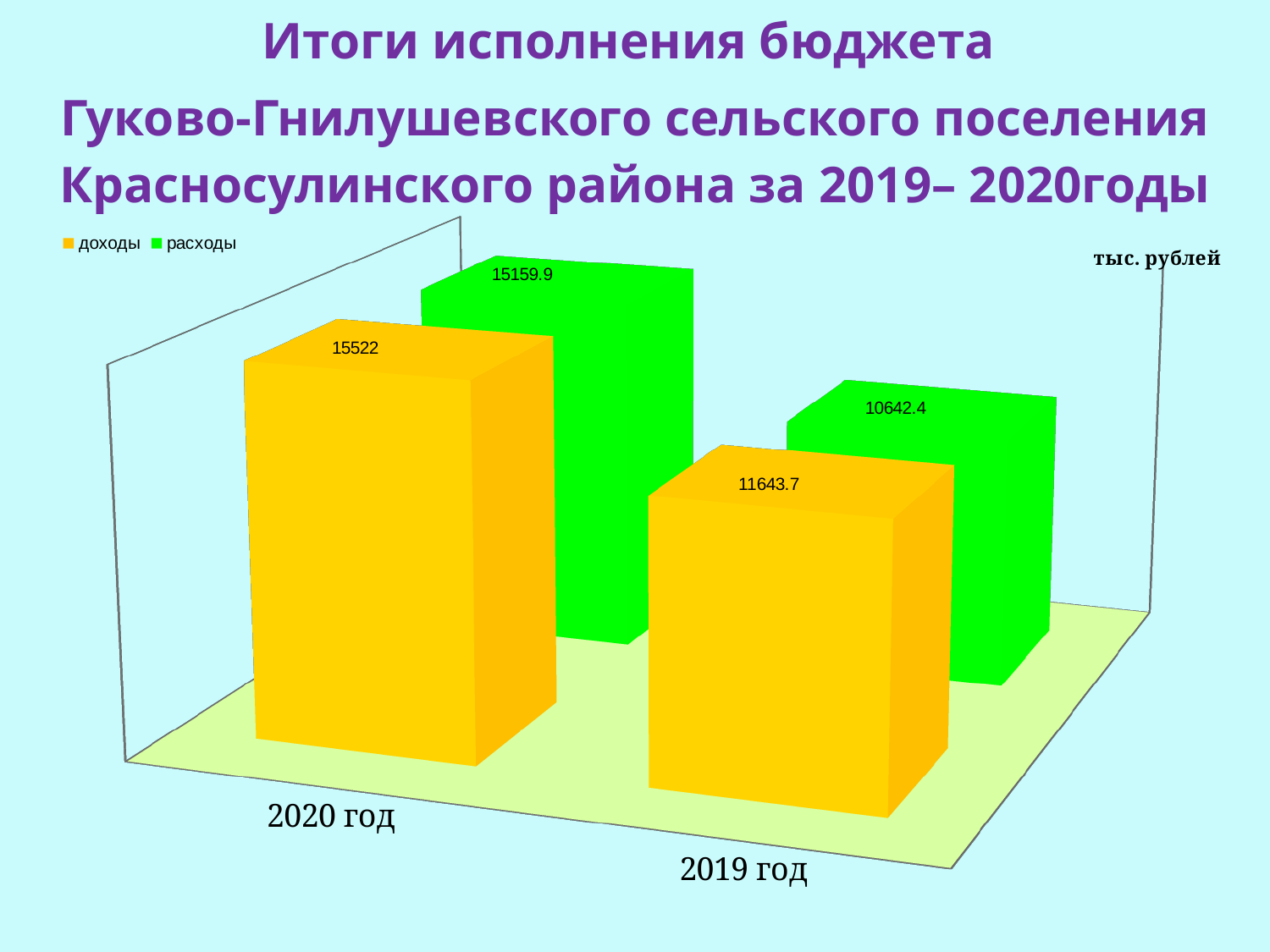
What is the value of расходы for 2019 год? 10642.4 Which year has the lowest расходы? 2019 год What unit is indicated for the values on the chart? тыс. рублей What is the difference between доходы and расходы for 2019 год? 1001.3 How many series does the legend list? 2 What kind of chart is shown on the slide? bar chart What is the value of расходы for 2020 год? 15159.9 Which is larger for 2020 год, доходы or расходы? доходы What is the value of доходы for 2019 год? 11643.7 What is the value of доходы for 2020 год? 15522 Which year has the highest доходы? 2020 год By how much did доходы in 2020 год exceed доходы in 2019 год? 3878.3